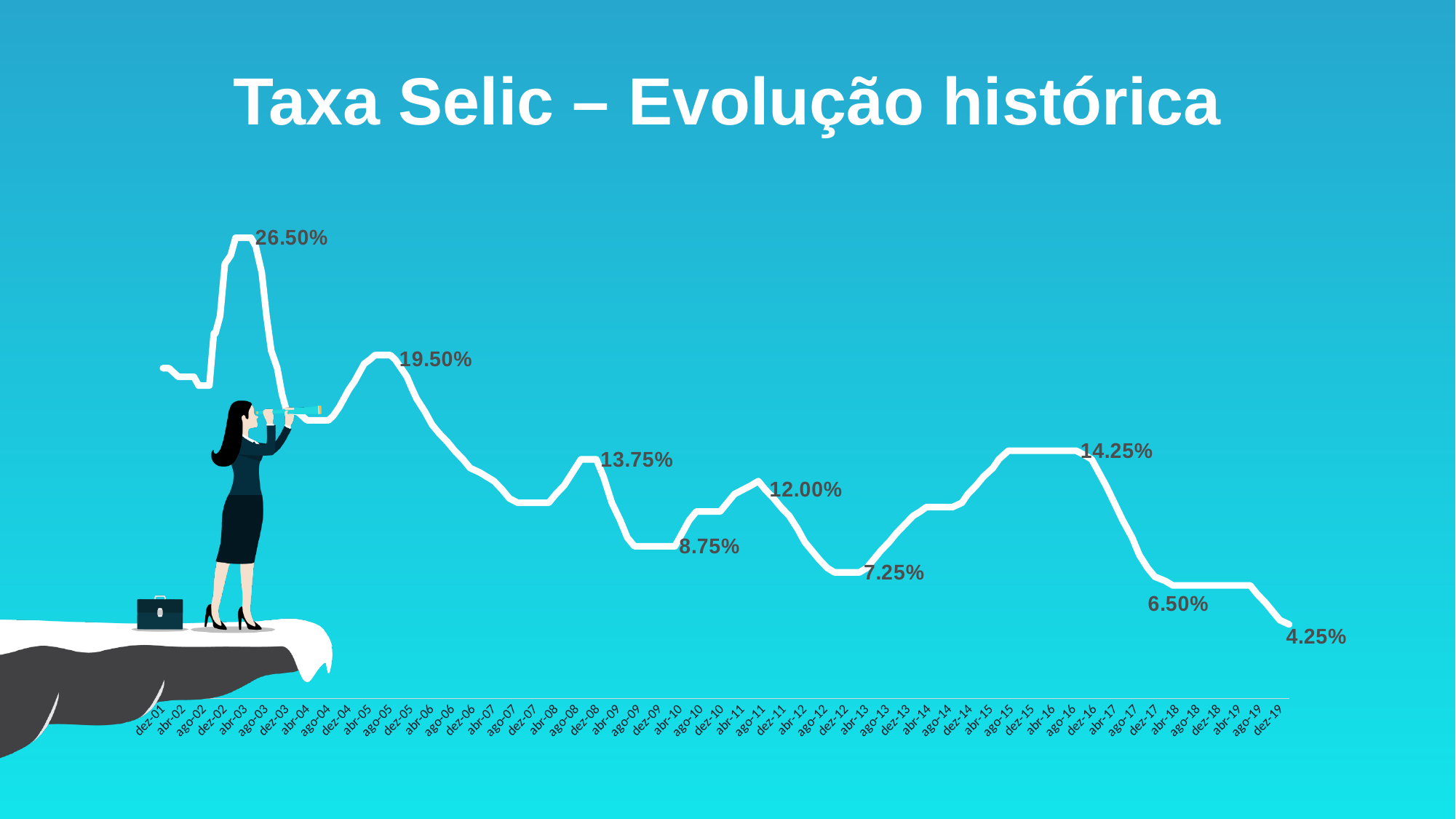
What is the lowest value labelled on the line? 4.25% What is the first x-axis label on the chart? dez-01 How many data labels are printed on the line? 9 What is the highest value labelled on the line? 26.50% What is the value of the Selic rate at the last point, dez-19? 4.25% Which labelled value is larger, 8.75% or 7.25%? 8.75% What is the title of the chart on the slide? Taxa Selic – Evolução histórica What is the difference between the labelled values 14.25% and 6.50%? 7.75% What kind of chart is shown on the slide? line chart Which labelled value is larger, 13.75% or 12.00%? 13.75% What is the difference between the labelled peak of 26.50% and the labelled value of 19.50%? 7.00% Overall, does the Selic rate rise or fall from its peak in 2003 to the end of the series in dez-19? fall